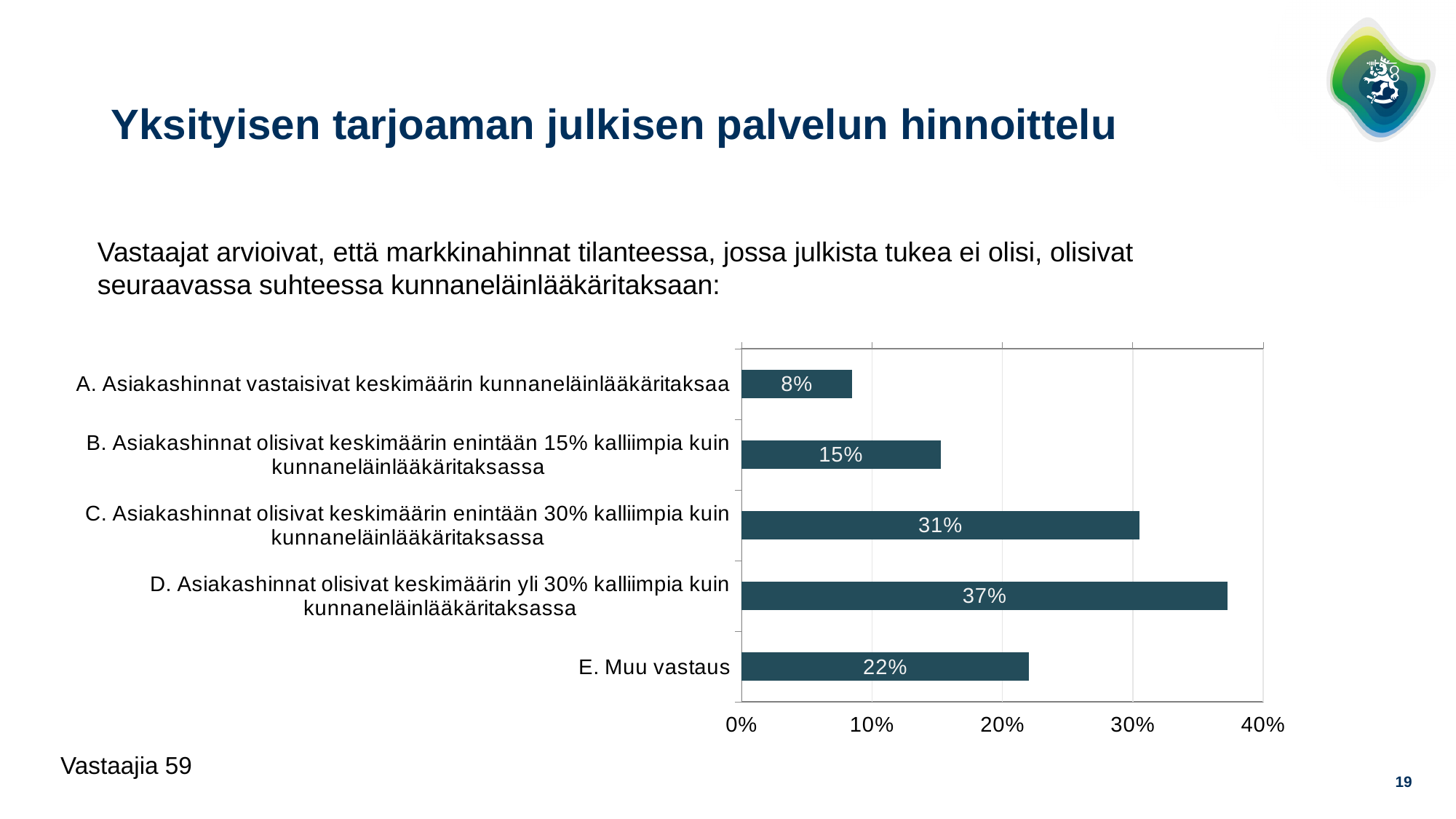
How many options (categories) are shown in the chart? 5 Which option has the highest value? D. Asiakashinnat olisivat keskimäärin yli 30% kalliimpia kuin kunnaneläinlääkäritaksassa Which option has the lowest value? A. Asiakashinnat vastaisivat keskimäärin kunnaneläinlääkäritaksaa How many respondents (Vastaajia) are stated on the slide? 59 What is the value for option D (Asiakashinnat olisivat keskimäärin yli 30% kalliimpia kuin kunnaneläinlääkäritaksassa)? 37% What kind of chart is shown on the slide? Bar chart What is the value for option E (Muu vastaus)? 22% What is the value for option A (Asiakashinnat vastaisivat keskimäärin kunnaneläinlääkäritaksaa)? 8% Is the value for option C greater or less than 30%? greater Which has a larger value, option C or option E? C. Asiakashinnat olisivat keskimäärin enintään 30% kalliimpia kuin kunnaneläinlääkäritaksassa What is the difference between the values for option E and option B? 7% What is the difference between the values for option D and option C? 6%